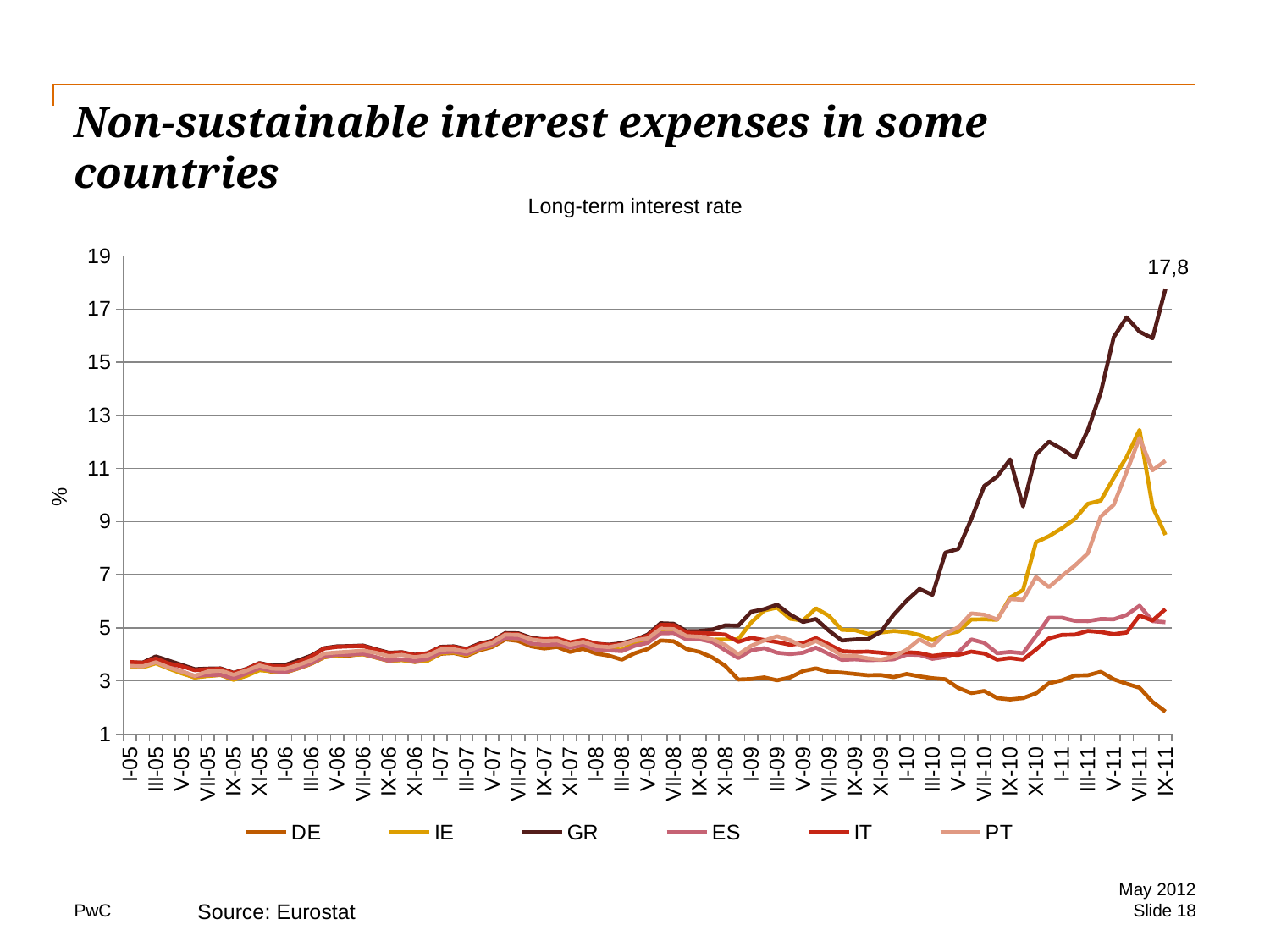
Does the DE line rise or fall between I-11 and IX-11? fall What kind of chart is shown on the slide? line chart What is the title of the chart? Long-term interest rate What is the value for GR at IX-11? 17,8 Is the value for IE at VII-11 greater or less than 11? greater At IX-11, which is higher, IE or PT? PT Which series has the lowest value at IX-11? DE Does the GR line rise or fall between I-10 and IX-11? rise Is the value for DE at IX-11 greater or less than 3? less Which series has the highest value at IX-11? GR Is the value for PT at IX-11 greater or less than 9? greater How many series does the legend list? 6